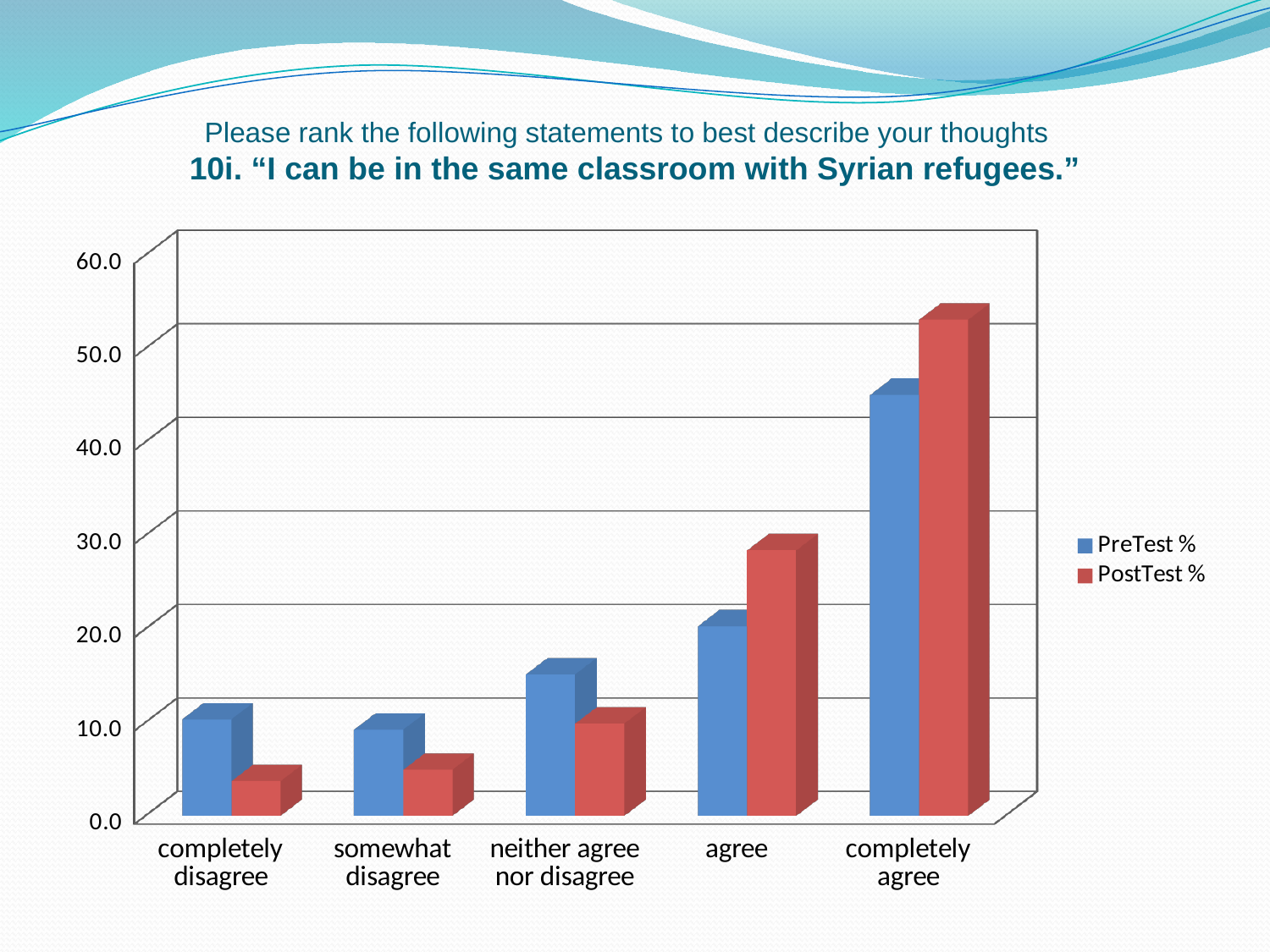
How many response categories are shown on the x axis? 5 How many series does the legend list? 2 Is the PreTest % value for completely agree greater or less than 50.0? less Is the PostTest % value for completely agree greater or less than 50.0? greater Is the PostTest % value for agree greater or less than 40.0? less What kind of chart is shown on the slide? bar chart Which category has the highest PostTest % value? completely agree For the neither agree nor disagree category, which is larger: PreTest % or PostTest %? PreTest % Do the PostTest % values rise or fall moving from completely disagree to completely agree along the x axis? rise Which category has the highest PreTest % value? completely agree For the agree category, which is larger: PreTest % or PostTest %? PostTest %